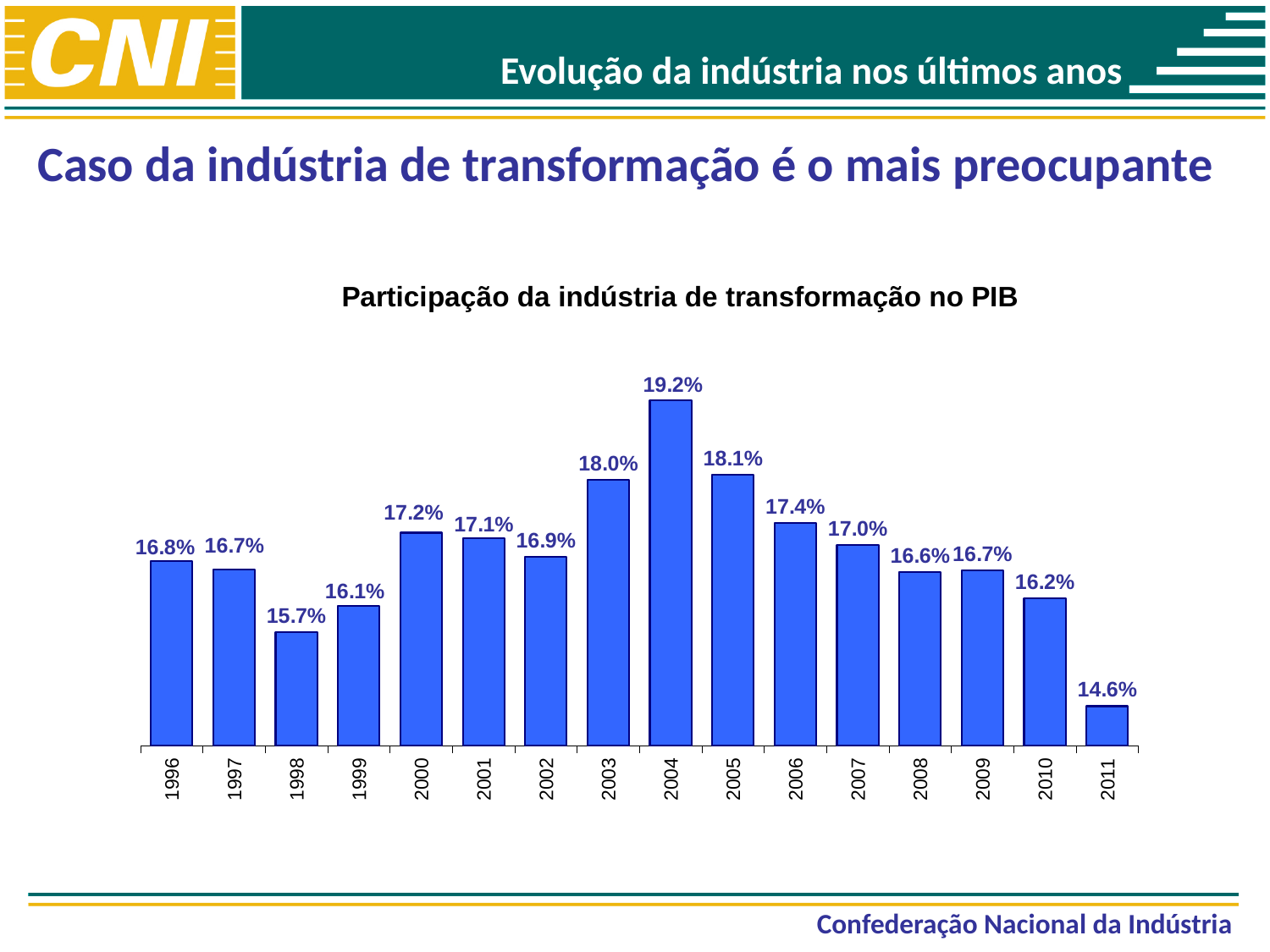
What is the title of the chart? Participação da indústria de transformação no PIB Which year has the lowest value? 2011 What is the difference between the values for 2004 and 2011? 4.6% What is the value for 2011? 14.6% Do the values rise or fall from 2005 to 2011? fall What is the difference between the values for 2003 and 2005? 0.1% Which year has the highest value? 2004 Which is larger, the value for 2000 or the value for 2006? 2006 What is the value for 2004? 19.2% What kind of chart is this? bar chart How many years are shown on the x axis? 16 What is the value for 1998? 15.7%